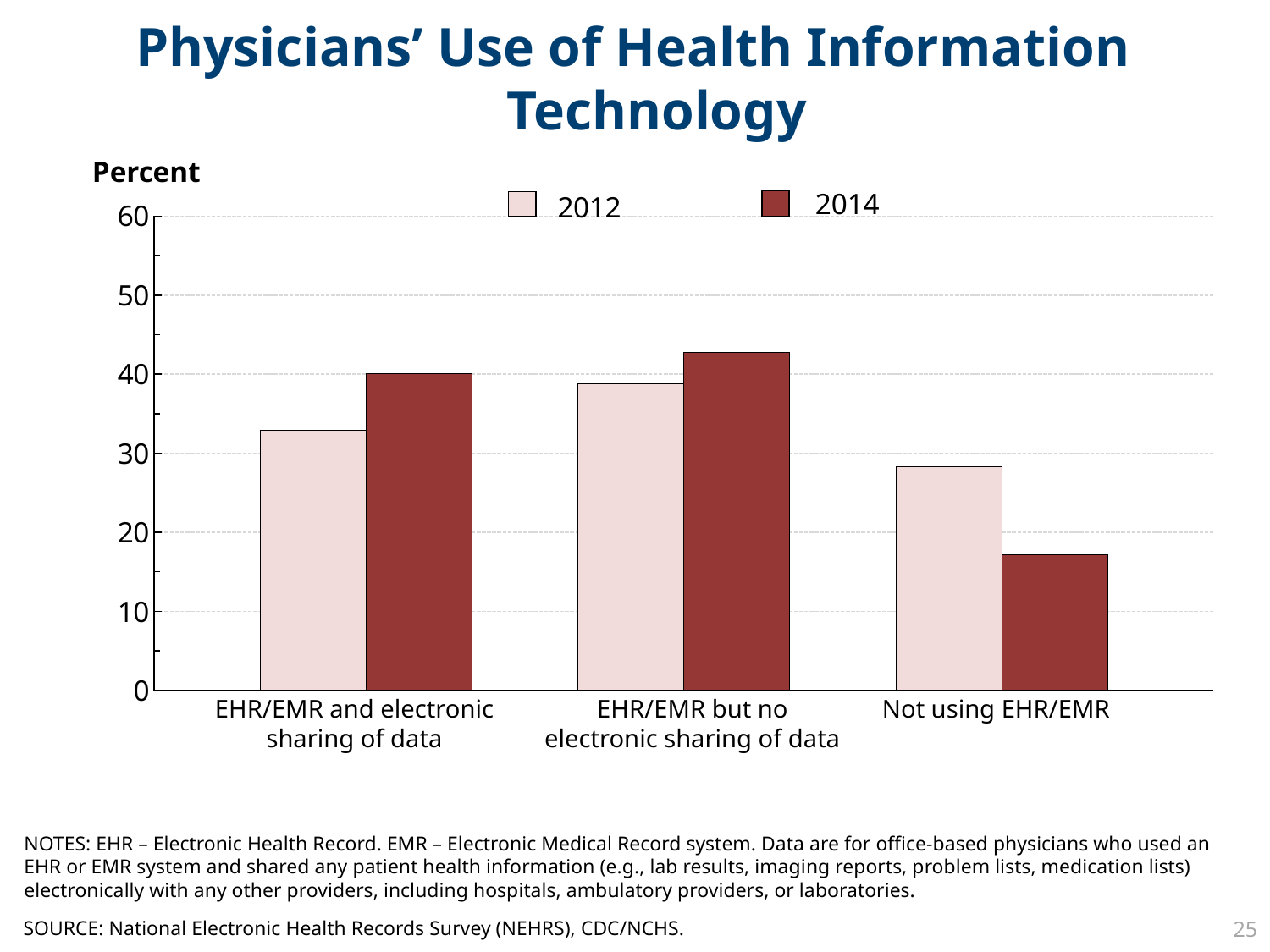
Which bar is the highest in the chart? 2014, EHR/EMR but no electronic sharing of data Is the 2012 value for Not using EHR/EMR greater or less than 30? less Is the 2014 value for EHR/EMR but no electronic sharing of data greater or less than 40? greater For Not using EHR/EMR, which year has the larger value, 2012 or 2014? 2012 For EHR/EMR and electronic sharing of data, which year has the larger value, 2012 or 2014? 2014 Which bar is the lowest in the chart? 2014, Not using EHR/EMR How many series does the legend list? 2 Is the 2012 value for EHR/EMR and electronic sharing of data greater or less than 30? greater What is the label on the vertical axis of the chart? Percent What kind of chart is shown on the slide? bar chart How many categories are shown on the x axis? 3